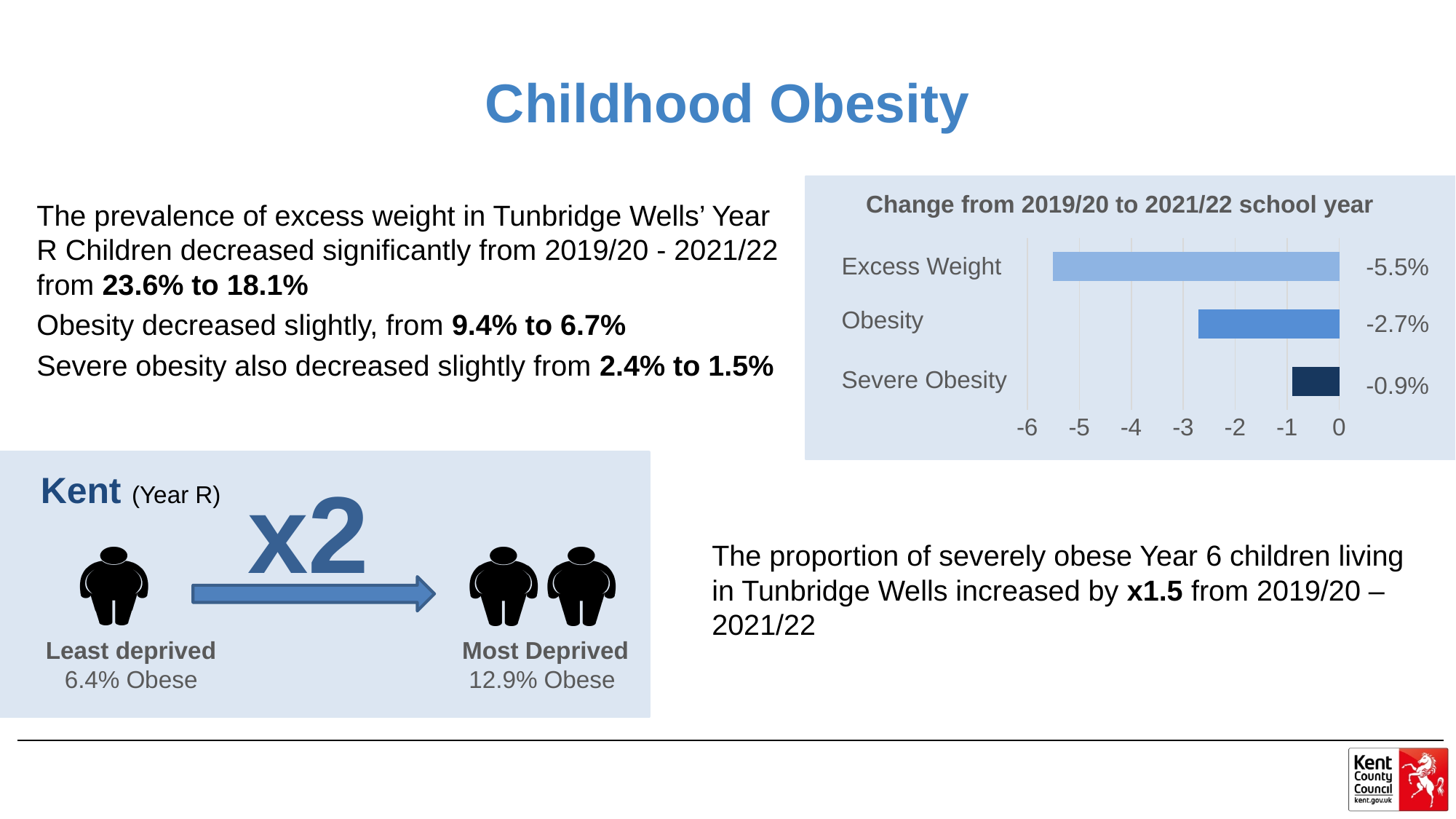
Which has the larger decrease in the chart, Obesity or Severe Obesity? Obesity What kind of chart is shown on the slide? Bar chart How many categories are shown in the chart? 3 Is the value for Excess Weight greater or less than -5? less By how many percentage points does the change for Excess Weight differ from the change for Obesity? 2.8 percentage points What is the change shown for Excess Weight in the chart? -5.5% Which category in the chart shows the largest decrease? Excess Weight What is the change shown for Obesity in the chart? -2.7% What is the title of the chart? Change from 2019/20 to 2021/22 school year What is the change shown for Severe Obesity in the chart? -0.9% Which category in the chart shows the smallest decrease? Severe Obesity Is the value for Obesity greater or less than -3? greater